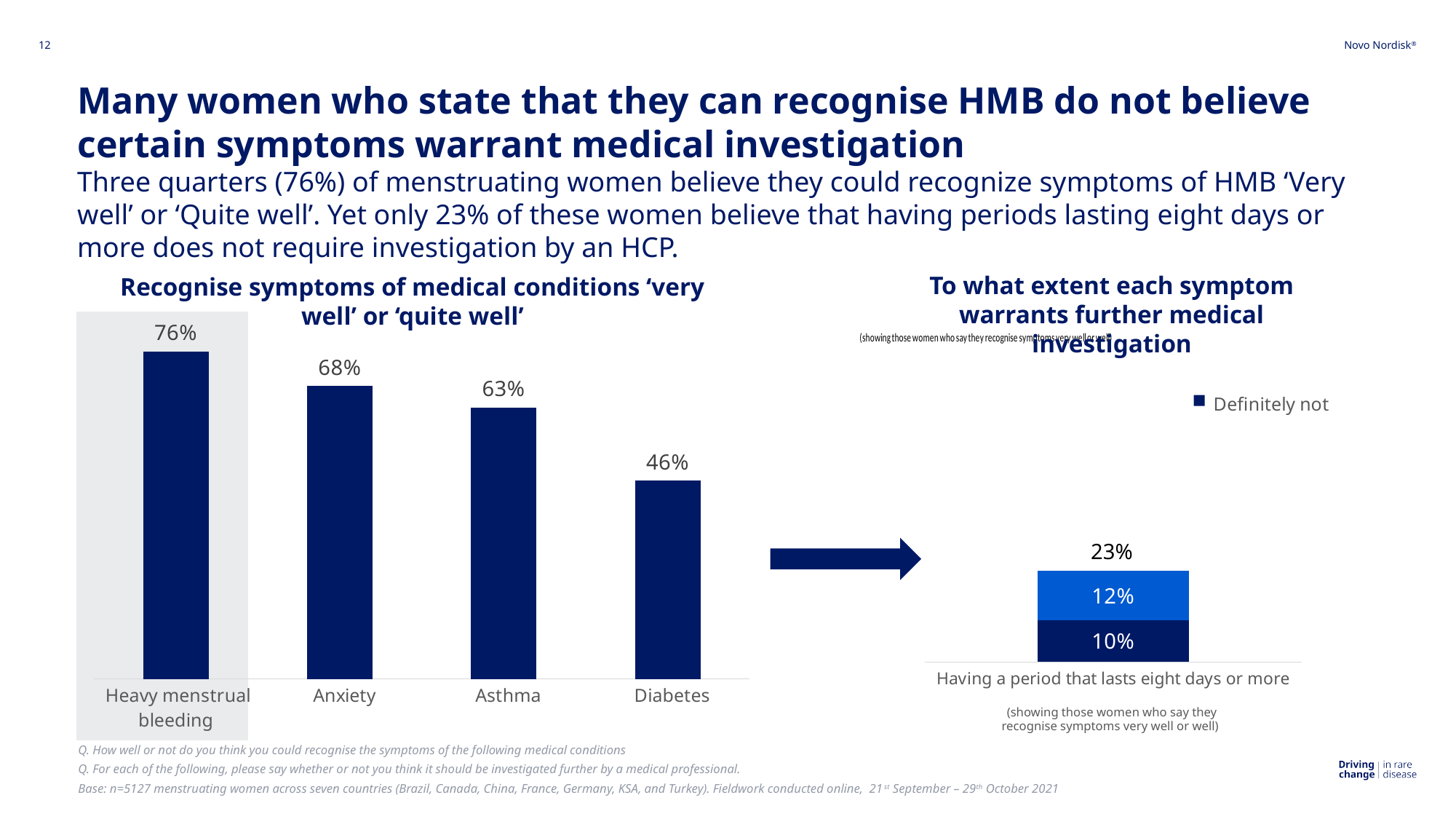
In the 'Recognise symptoms of medical conditions' chart, what is the value for Anxiety? 68% In the 'Recognise symptoms of medical conditions' chart, what is the value for Diabetes? 46% In the 'Recognise symptoms of medical conditions' chart, what is the difference between the values for Anxiety and Asthma? 5% In the 'Recognise symptoms of medical conditions' chart, do the values rise or fall from left to right? Fall What kind of chart is the 'Recognise symptoms of medical conditions' chart? Bar chart In the 'Recognise symptoms of medical conditions' chart, which condition has the lowest value? Diabetes How many conditions are shown in the 'Recognise symptoms of medical conditions' chart? 4 In the 'Recognise symptoms of medical conditions' chart, which condition has the highest value? Heavy menstrual bleeding In the 'To what extent each symptom warrants further medical investigation' chart, what is the total of the stacked bar for 'Having a period that lasts eight days or more'? 23% In the 'Recognise symptoms of medical conditions' chart, which is larger, the value for Asthma or the value for Diabetes? Asthma In the 'Recognise symptoms of medical conditions' chart, what is the value for Heavy menstrual bleeding? 76% In the 'To what extent each symptom warrants further medical investigation' chart, what is the value of the bottom (dark blue) segment of the stacked bar? 10%